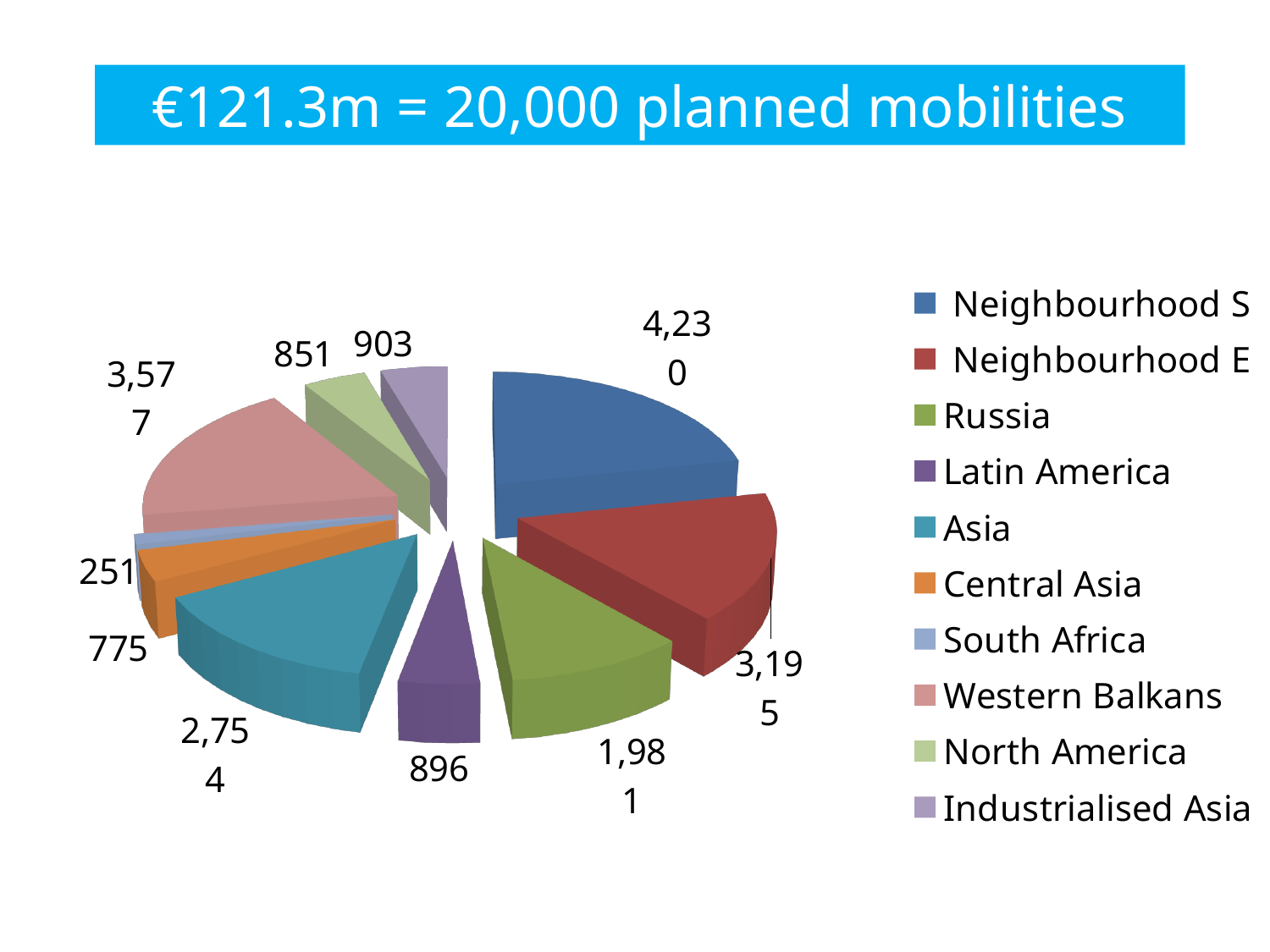
How many categories does the pie chart have? 10 What is the title shown at the top of the slide? €121.3m = 20,000 planned mobilities Which is larger, the value for Russia or the value for Asia? Asia What is the value for Neighbourhood S? 4,230 What is the value for Asia? 2,754 What kind of chart is shown on the slide? Pie chart Which category has the smallest slice? South Africa What is the value for Western Balkans? 3,577 Which category has the largest slice? Neighbourhood S What is the value for South Africa? 251 What is the difference between the values for Neighbourhood S and Neighbourhood E? 1,035 How many entries does the legend list? 10